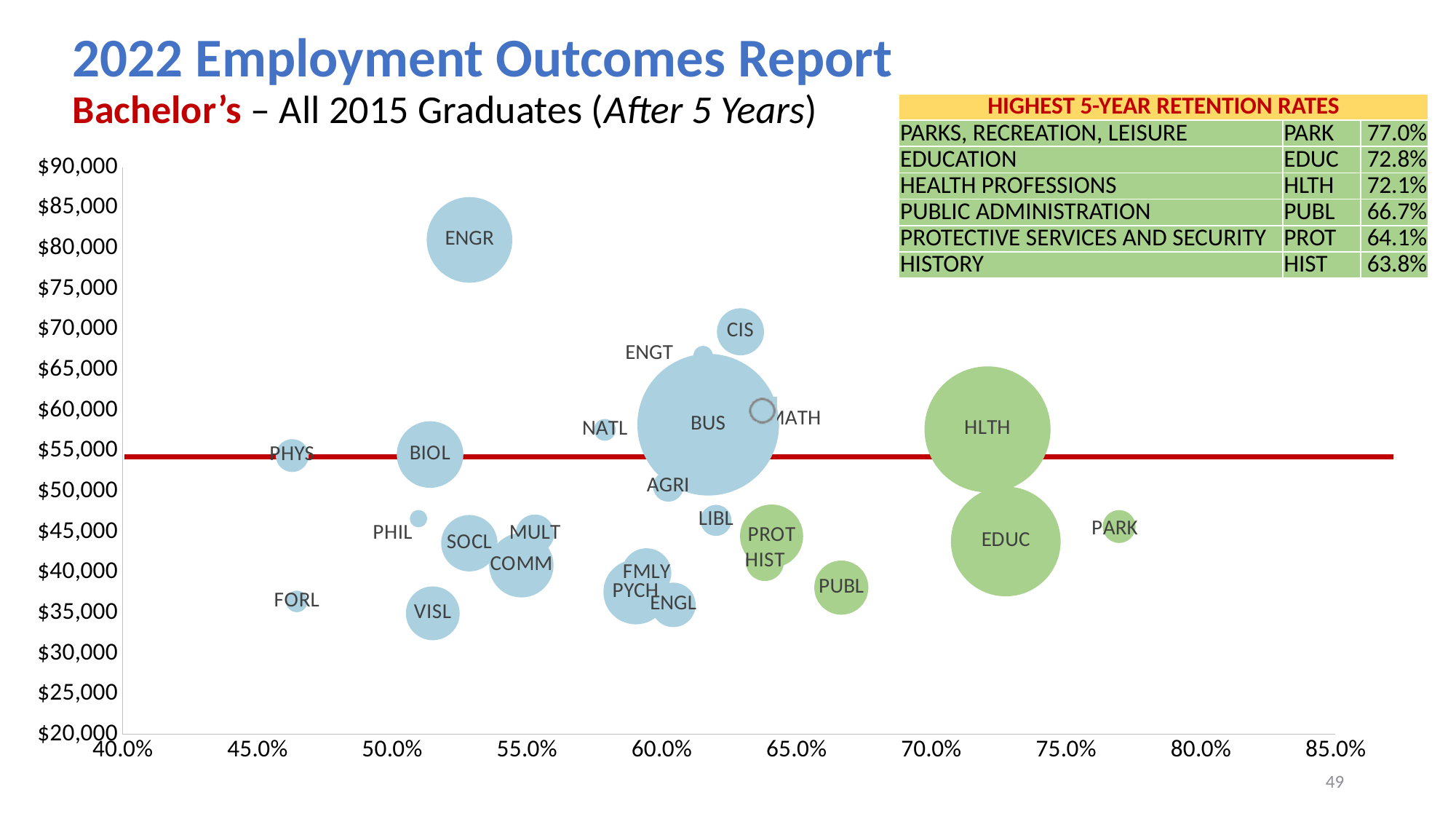
Is the salary value for FORL greater or less than $40,000? less Is the retention rate for ENGR greater or less than 55.0%? less According to the retention rates table, what is the 5-year retention rate for HIST (History)? 63.8% Is the retention rate for HLTH greater or less than 70.0%? greater Which has a higher 5-year retention rate in the table, EDUC or HLTH? EDUC Which program bubble is furthest to the right (highest retention rate) on the chart? PARK Which program bubble has the highest salary on the chart? ENGR According to the retention rates table, what is the 5-year retention rate for PARK (Parks, Recreation, Leisure)? 77.0% What kind of chart is shown on the slide? bubble chart What is the difference in 5-year retention rate between PARK and EDUC in the table? 4.2%